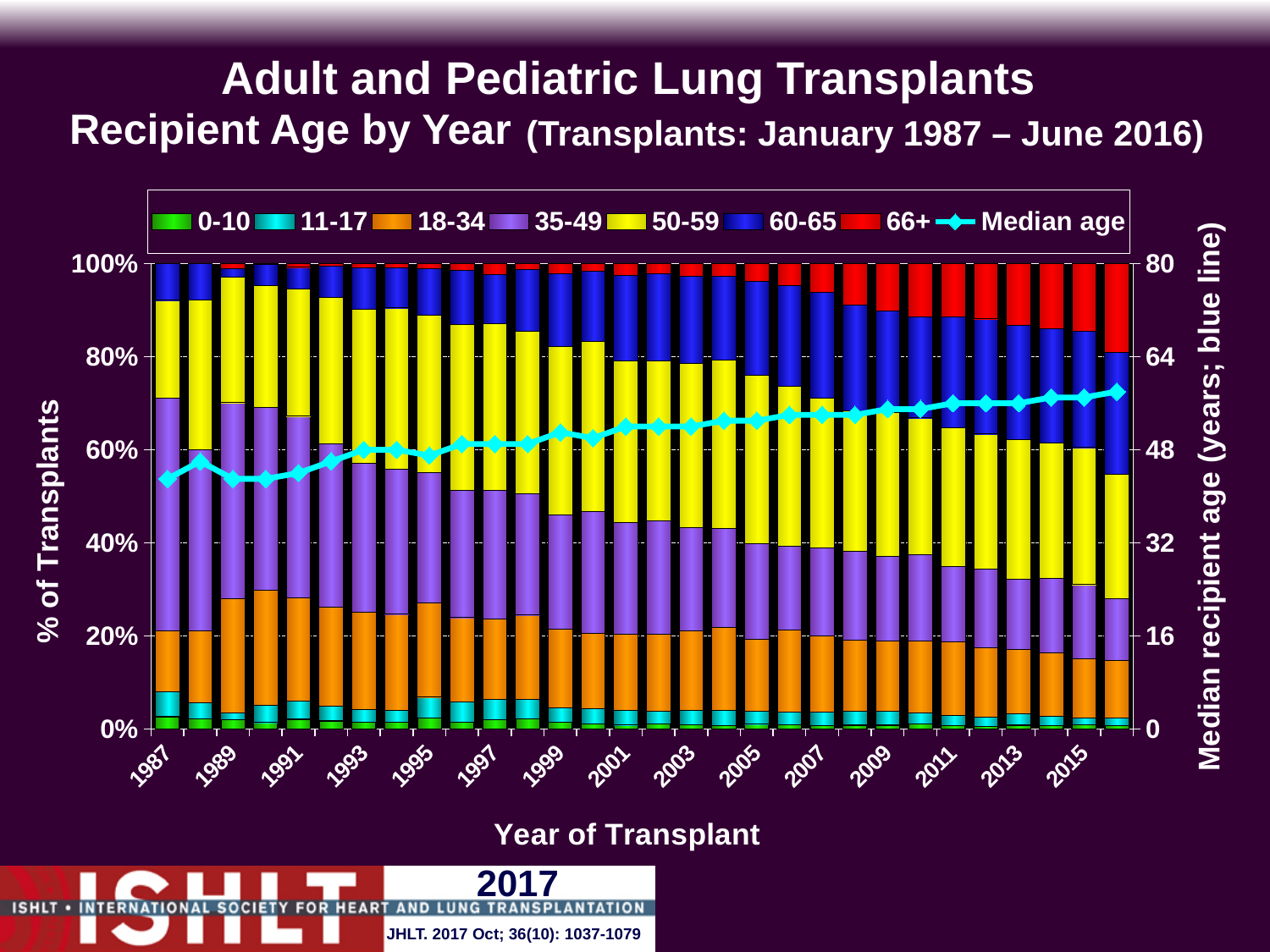
Does the median recipient age rise or fall from 1987 to 2016? Rises Is the median recipient age in 1987 greater or less than 48 years? less Which colour represents the 66+ age group in the legend? Red How many years (bars) are plotted along the x axis? 30 Is the median recipient age in 2016 greater or less than 48 years? greater What do the stacked segments of each bar add up to? 100% What kind of chart is shown on the slide? Stacked bar chart with a line How many entries does the legend list? 8 What is the title of the x axis? Year of Transplant Which year has the highest median recipient age? 2016 Is the median recipient age larger in 1987 or in 2016? 2016 Does the share of recipients aged 66+ rise or fall over the years shown? Rises